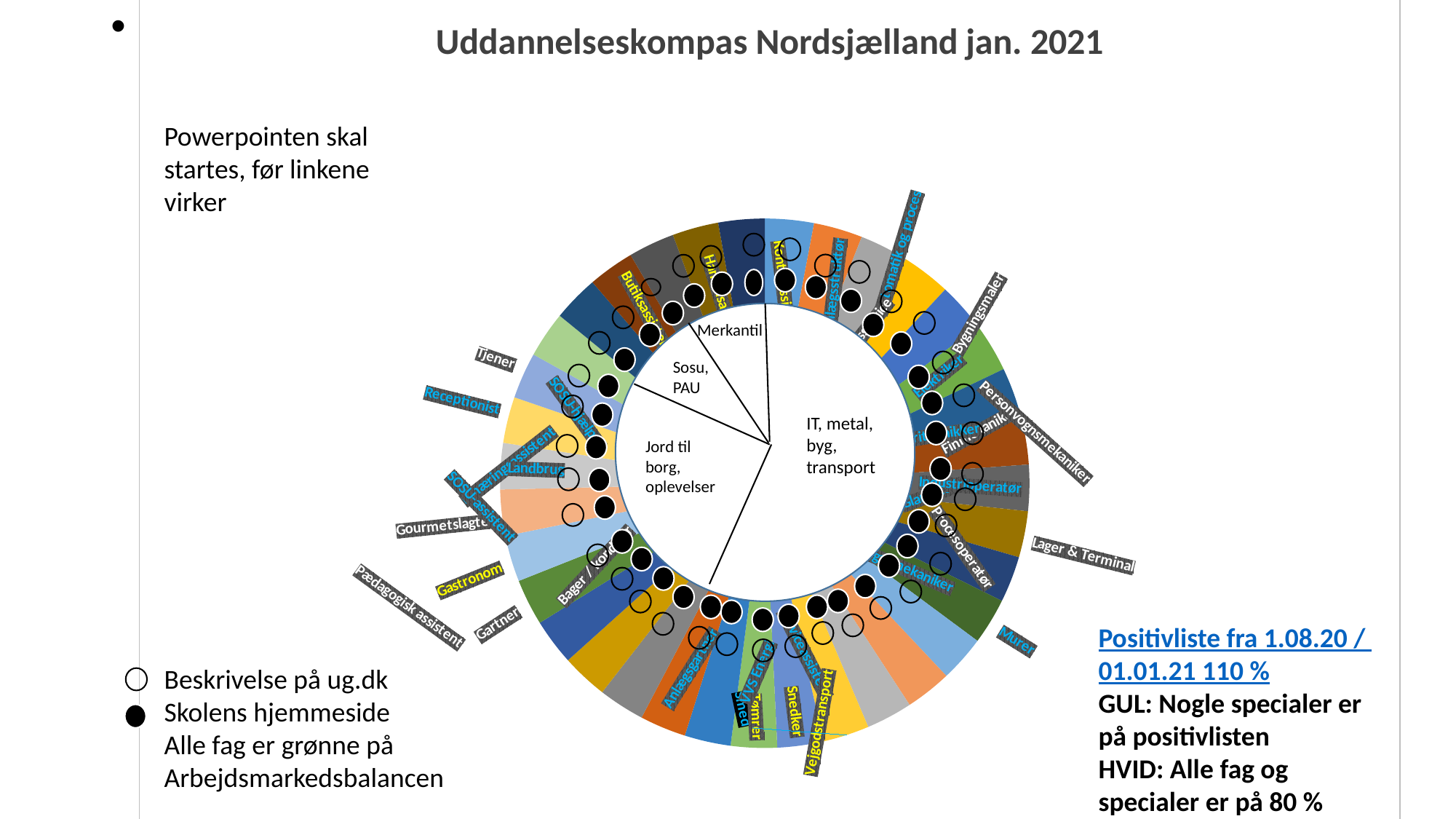
What is the title of the chart? Uddannelseskompas Nordsjælland jan. 2021 According to the legend, what does an open (hollow) circle on the chart indicate? Beskrivelse på ug.dk In which sector of the chart does the label 'Lager & Terminal' appear? IT, metal, byg, transport What kind of chart is shown on the slide? doughnut chart Which sector of the chart is labelled on the right side of the ring? IT, metal, byg, transport How many main sectors are labelled inside the ring of the chart? 4 Which sector of the chart is labelled at the top of the ring? Merkantil In which sector of the chart does the label 'Murer' appear? IT, metal, byg, transport Which sector of the chart is labelled 'Jord til borg, oplevelser'? the lower-left sector